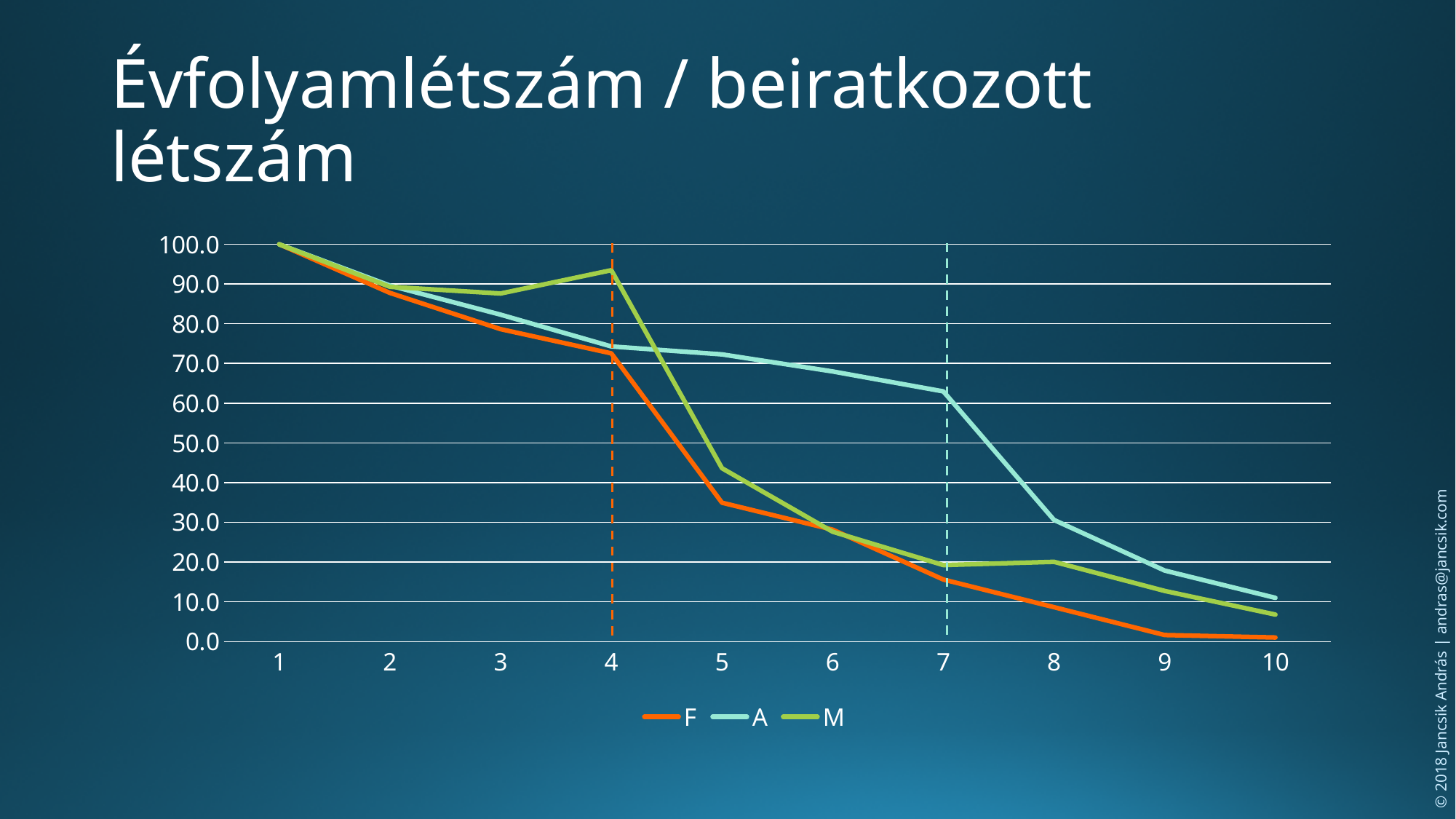
What kind of chart is shown on the slide? line chart Is the value of series M at x = 10 greater or less than 10? less Do the values of series F rise or fall from x = 1 to x = 10? fall How many points are there along the x axis? 10 What are the legend entries of the chart? F, A, M Is the value of series F at x = 5 greater or less than 30? greater At x = 8, which series has the larger value, A or F? A At x = 5, which series has the larger value, A or F? A What is the value of series F at x = 1? 100.0 How many series does the legend list? 3 Is the value of series A at x = 7 greater or less than 60? greater